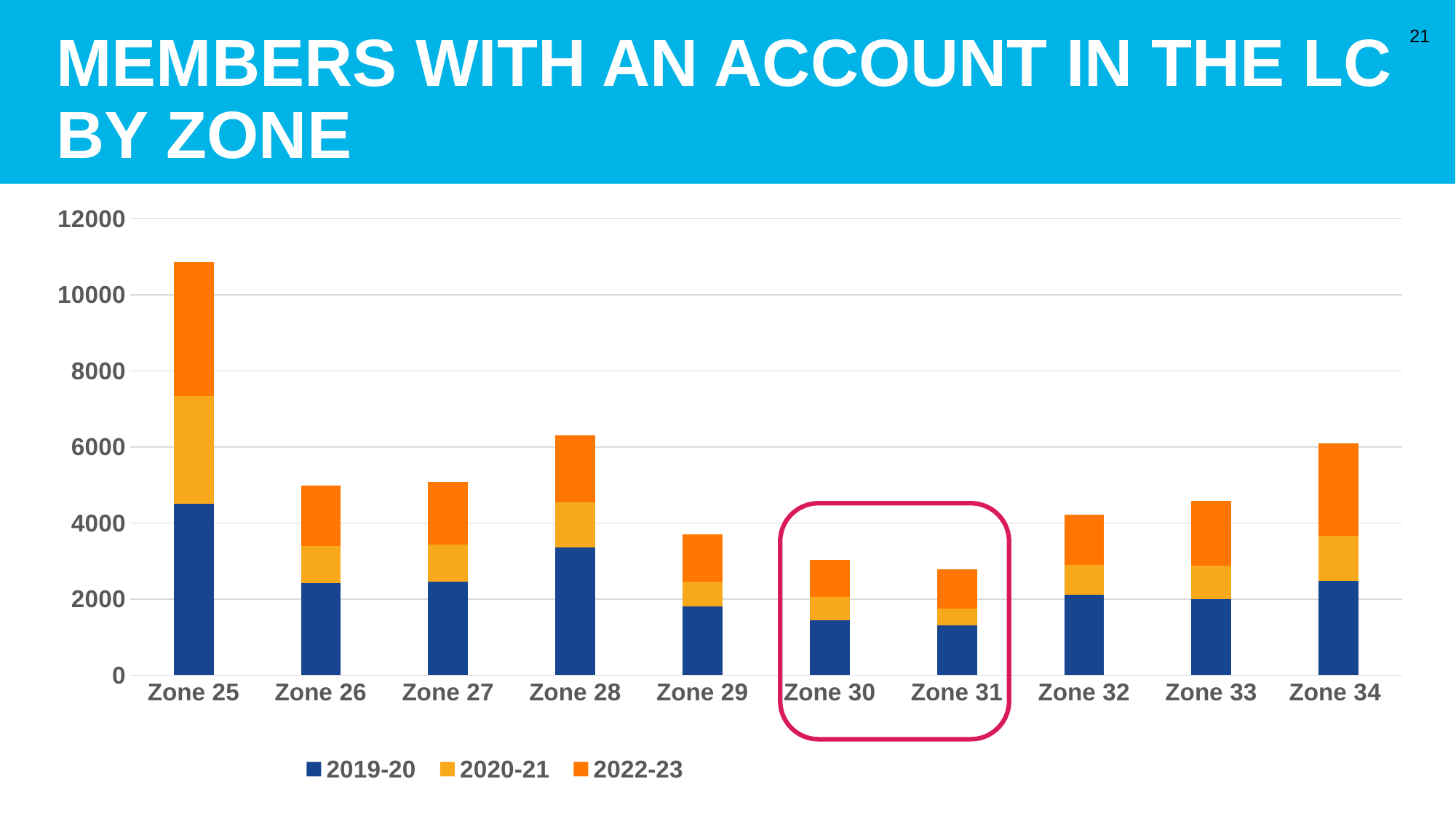
Which two zones are highlighted with a pink rounded outline on the chart? Zone 30 and Zone 31 Which zone has the lowest total stacked bar? Zone 31 Is the total stacked value for Zone 33 greater or less than 6000? less What kind of chart is shown on the slide? Stacked bar chart How many zones are shown on the x axis of the chart? 10 How many series does the chart's legend list? 3 Which has the larger total stacked bar, Zone 33 or Zone 34? Zone 34 Is the total stacked value for Zone 29 greater or less than 4000? less Is the 2019-20 value for Zone 25 greater or less than 4000? greater Which zone has the highest total stacked bar? Zone 25 Which has the larger total stacked bar, Zone 27 or Zone 28? Zone 28